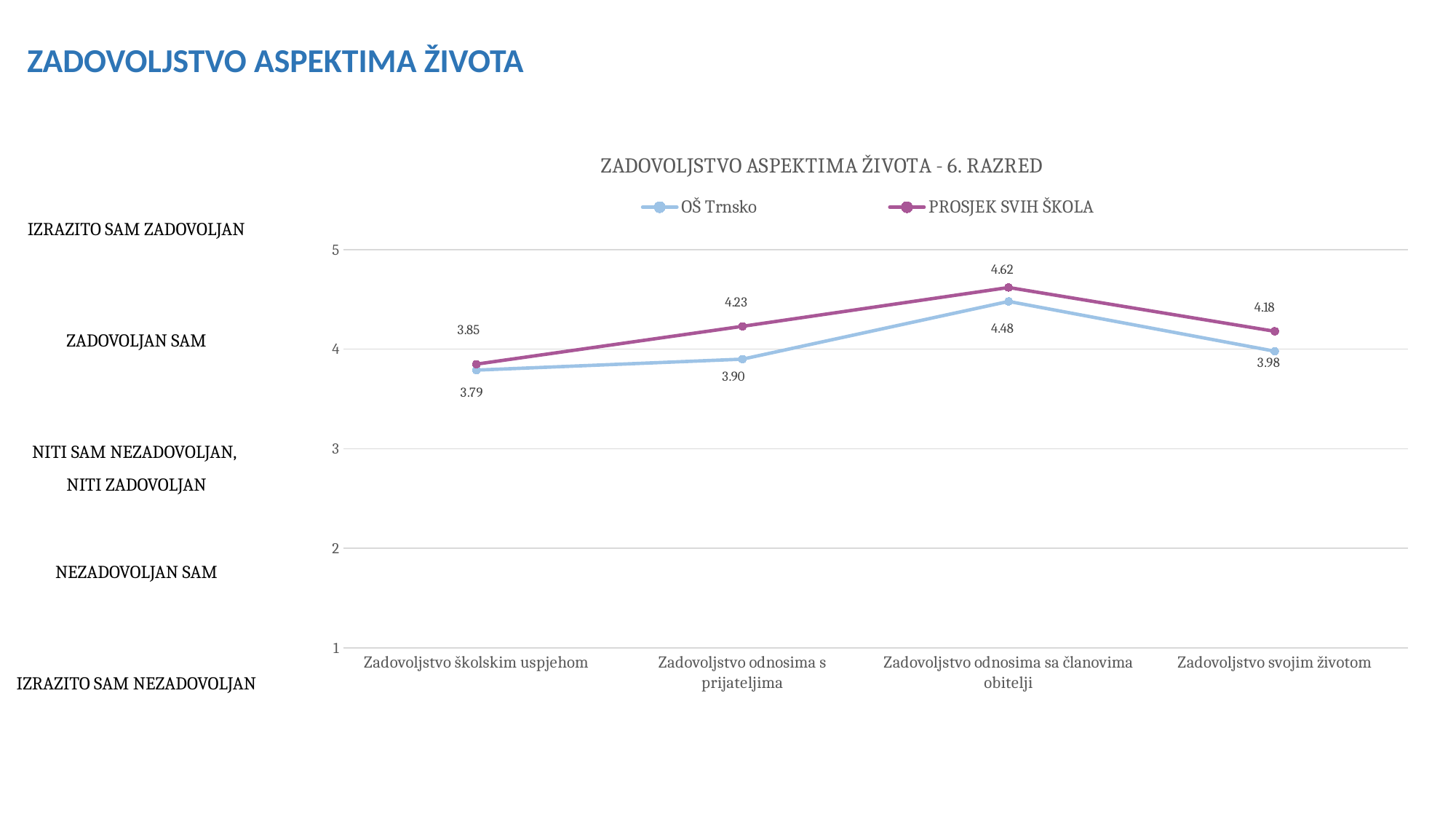
What is the value for PROSJEK SVIH ŠKOLA for Zadovoljstvo odnosima s prijateljima? 4.23 How many series does the legend list? 2 What is the value for OŠ Trnsko for Zadovoljstvo školskim uspjehom? 3.79 What is the title of the chart? ZADOVOLJSTVO ASPEKTIMA ŽIVOTA - 6. RAZRED Which category has the highest value for OŠ Trnsko? Zadovoljstvo odnosima sa članovima obitelji Which category has the lowest value for PROSJEK SVIH ŠKOLA? Zadovoljstvo školskim uspjehom What is the value for PROSJEK SVIH ŠKOLA for Zadovoljstvo odnosima sa članovima obitelji? 4.62 Which series has the larger value for Zadovoljstvo svojim životom, OŠ Trnsko or PROSJEK SVIH ŠKOLA? PROSJEK SVIH ŠKOLA What is the difference between PROSJEK SVIH ŠKOLA and OŠ Trnsko for Zadovoljstvo odnosima s prijateljima? 0.33 What is the value for OŠ Trnsko for Zadovoljstvo svojim životom? 3.98 What kind of chart is shown on the slide? Line chart How many categories are shown on the x axis? 4